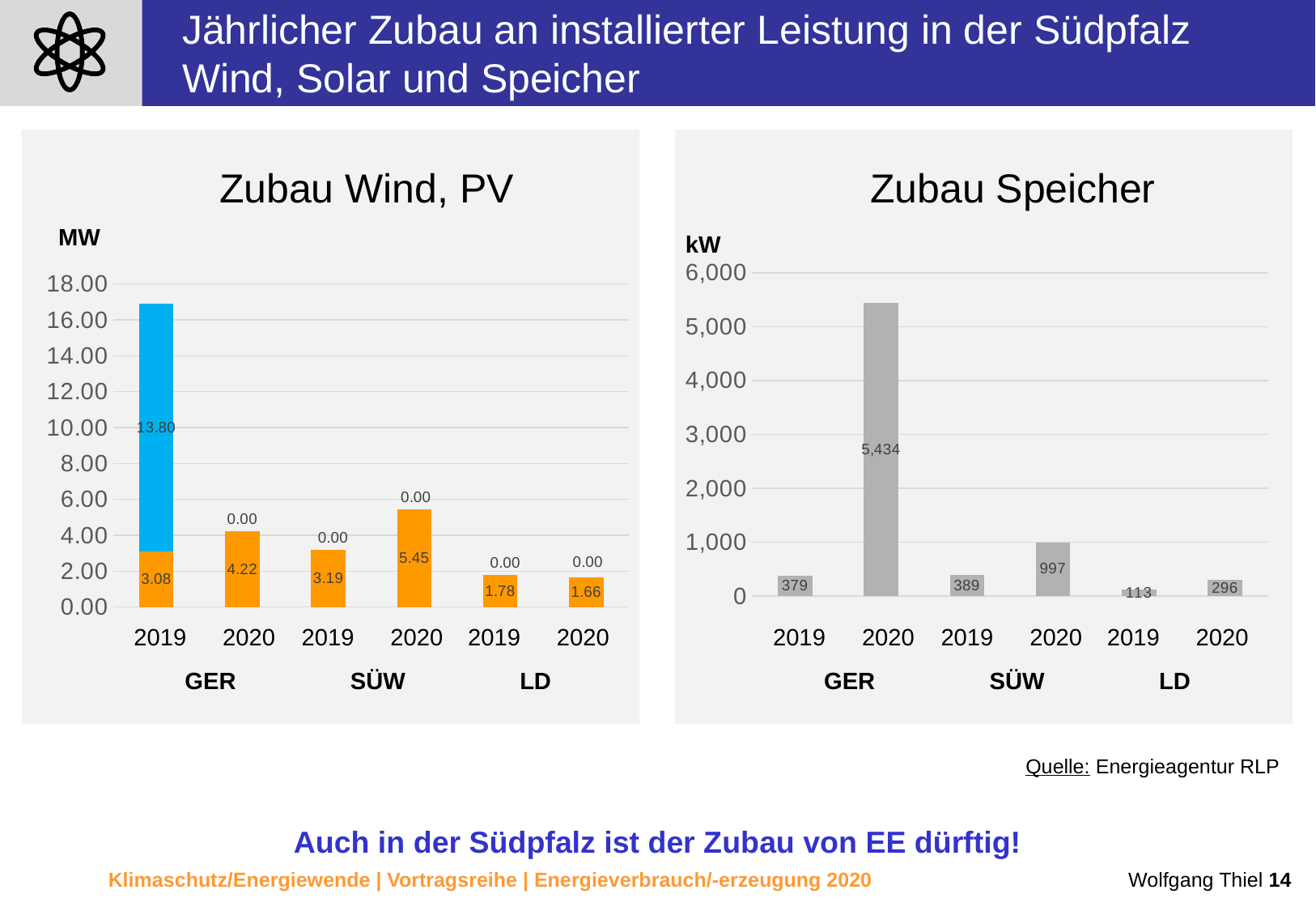
In the 'Zubau Speicher' chart, what is the difference between SÜW 2020 and SÜW 2019? 608 In the 'Zubau Wind, PV' chart, which is larger, the orange segment for LD 2019 or LD 2020? LD 2019 What unit is shown on the vertical axis of the 'Zubau Wind, PV' chart? MW In the 'Zubau Speicher' chart, what is the value for LD in 2019? 113 In the 'Zubau Speicher' chart, how many bars are plotted? 6 In the 'Zubau Speicher' chart, what is the value for GER in 2020? 5,434 In the 'Zubau Speicher' chart, which bar is the lowest? LD 2019 In the 'Zubau Wind, PV' chart, what is the value of the orange segment for SÜW in 2020? 5.45 In the 'Zubau Wind, PV' chart, what is the value of the blue segment for GER in 2019? 13.80 What kind of chart is 'Zubau Speicher'? Bar chart In the 'Zubau Speicher' chart, which bar is the highest? GER 2020 In the 'Zubau Wind, PV' chart, what is the total of the stacked bar for GER in 2019? 16.88